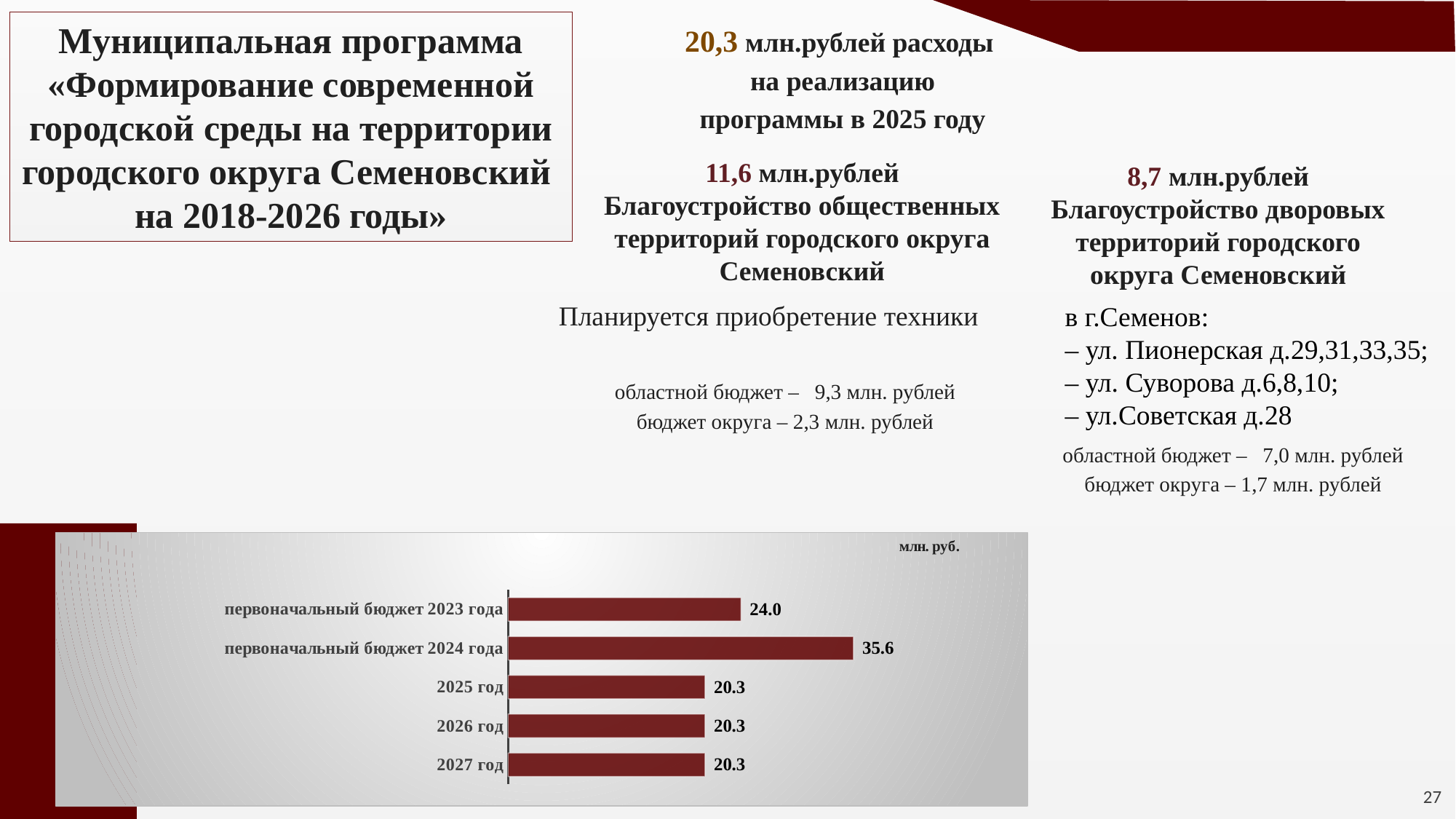
What is the value for "первоначальный бюджет 2023 года" in the bar chart? 24.0 What is the value for "2027 год" in the bar chart? 20.3 Which is larger: the value for "первоначальный бюджет 2023 года" or the value for "2026 год"? первоначальный бюджет 2023 года What is the value for "2025 год" in the bar chart? 20.3 Which category has the highest value in the bar chart? первоначальный бюджет 2024 года What is the value for "первоначальный бюджет 2024 года" in the bar chart? 35.6 How many categories (bars) are shown in the bar chart? 5 What is the difference between the values for "первоначальный бюджет 2024 года" and "первоначальный бюджет 2023 года"? 11.6 What unit label is shown in the top right corner of the chart? млн. руб. Do the values for 2025, 2026 and 2027 change from year to year in the bar chart? No, they stay at 20.3 What is the difference between the values for "первоначальный бюджет 2023 года" and "2025 год"? 3.7 What kind of chart is shown at the bottom of the slide? bar chart